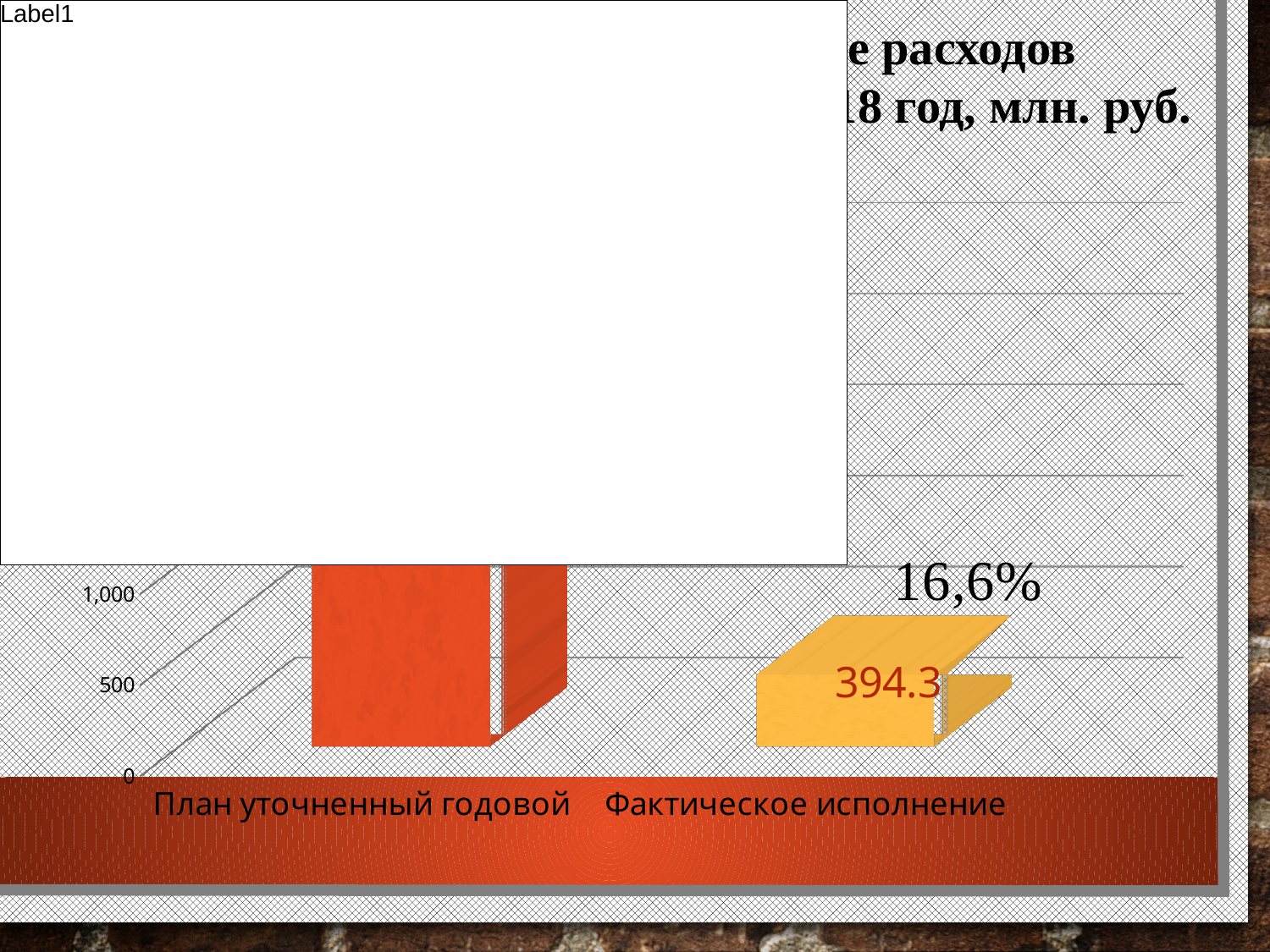
Which category has the lowest value? Фактическое исполнение What kind of chart is shown on the slide? bar chart What percentage is printed above the Фактическое исполнение bar? 16,6% Which is larger, План уточненный годовой or Фактическое исполнение? План уточненный годовой What colour is the bar for Фактическое исполнение? yellow Which category has the highest value? План уточненный годовой Is the value for План уточненный годовой greater or less than 500? greater Is the value for Фактическое исполнение greater or less than 500? less What is the value shown for Фактическое исполнение? 394.3 How many categories are shown on the x axis of the chart? 2